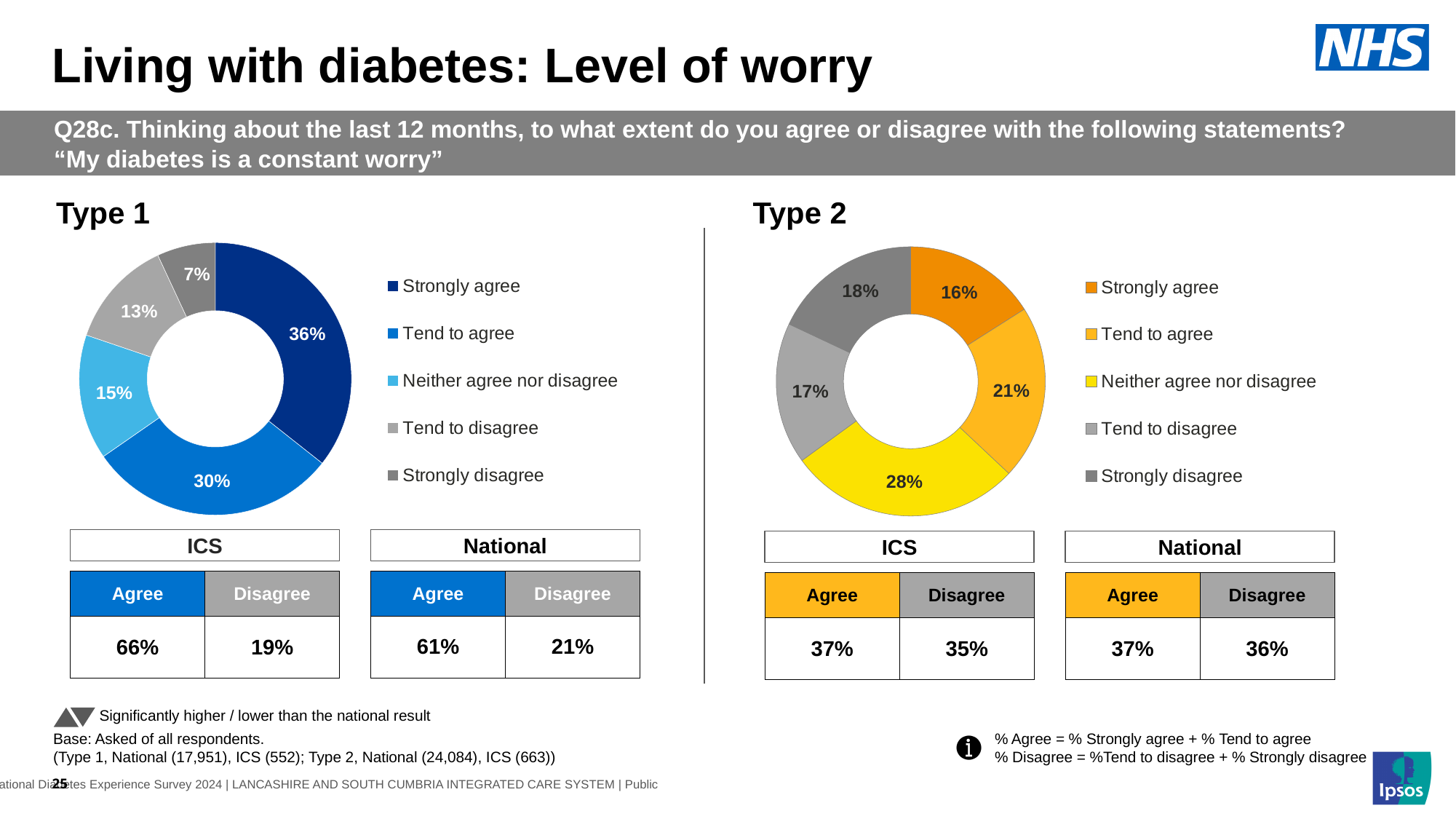
In the Type 1 chart, what is the difference between the Strongly agree and Tend to agree shares? 6 percentage points In the Type 2 chart, what percentage of respondents strongly disagree? 18% In the Type 1 chart, what colour is the Strongly agree segment? Dark blue What kind of chart is used for Type 1? Donut (pie) chart How many categories does the Type 2 chart's legend list? 5 In the Type 2 chart, what is the difference between the Neither agree nor disagree and Strongly agree shares? 12 percentage points In the Type 1 chart, what percentage of respondents strongly agree? 36% In the Type 1 chart, what is the combined share of Tend to disagree and Strongly disagree? 20% In the Type 1 chart, which response category has the smallest share? Strongly disagree In the Type 2 chart, what percentage of respondents neither agree nor disagree? 28% In the Type 2 chart, which response category has the largest share? Neither agree nor disagree In the Type 2 chart, which is larger: Tend to agree or Strongly agree? Tend to agree